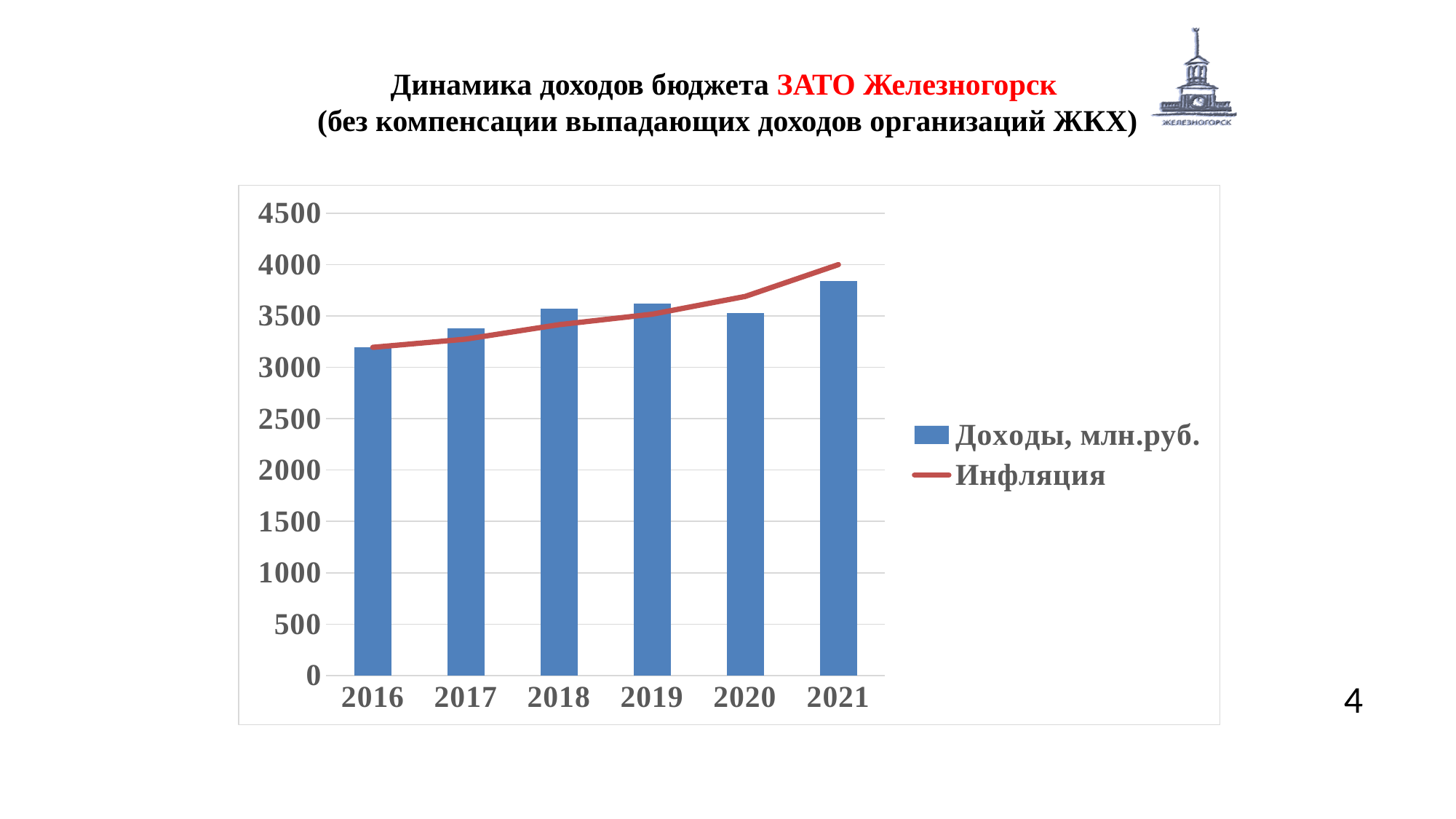
Which year has the lowest bar for Доходы, млн.руб.? 2016 How many years are shown on the x axis of the chart? 6 Is the Доходы bar for 2021 greater or less than 4000? less How many series does the chart legend list? 2 Does the Инфляция line rise or fall from 2016 to 2021? rises What colour is the Инфляция line in the chart? Red Which is larger, the Доходы bar for 2018 or for 2017? 2018 Is the Доходы bar for 2017 greater or less than 3500? less Is the Доходы bar for 2016 greater or less than 3000? greater What kind of chart is shown on the slide? A bar chart with a line Which year has the highest bar for Доходы, млн.руб.? 2021